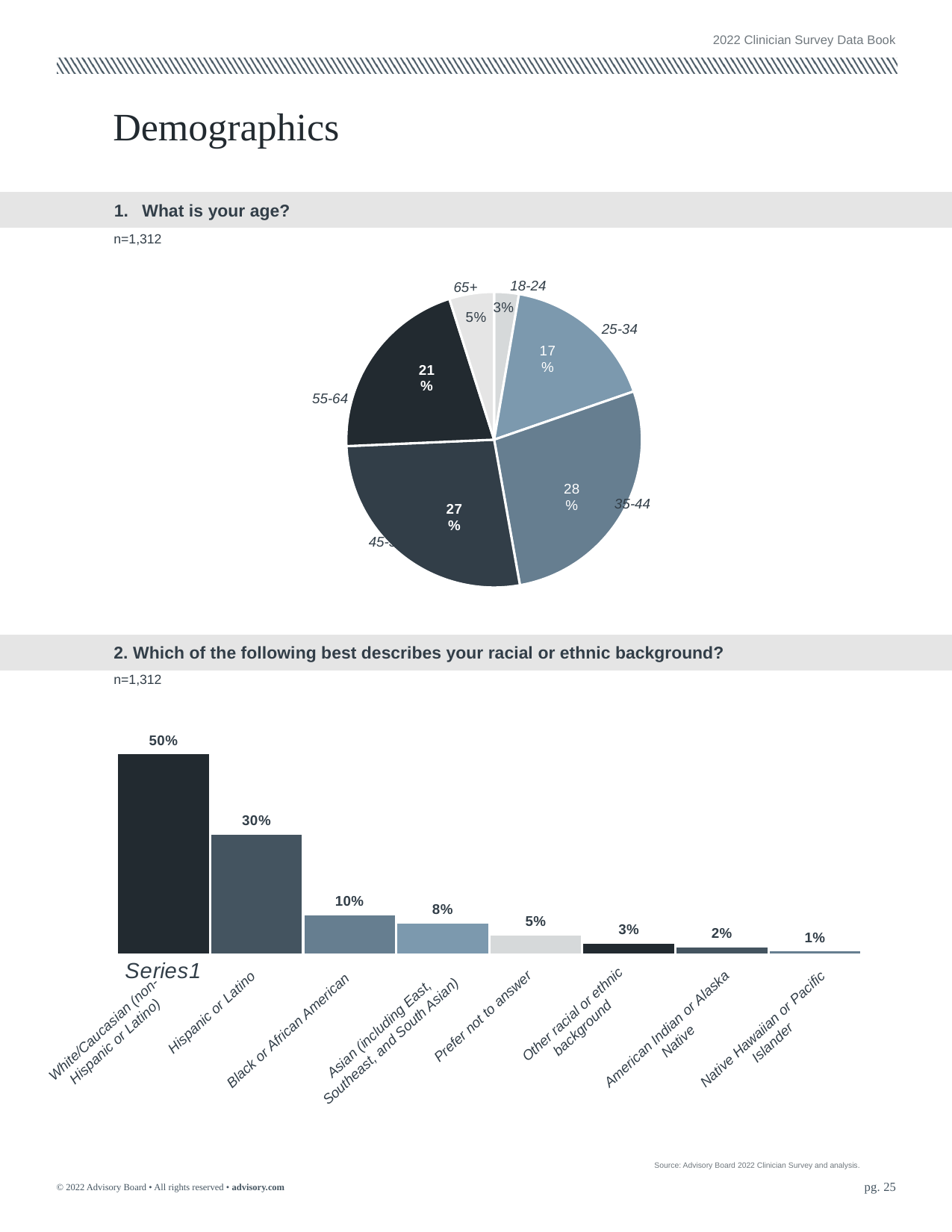
In the 'What is your age?' chart, which age group has the largest share? 35-44 In the racial or ethnic background chart, what percentage of respondents chose 'Prefer not to answer'? 5% In the racial or ethnic background chart, how many categories are shown? 8 In the 'What is your age?' chart, what percentage of respondents are aged 65+? 5% In the 'What is your age?' chart, what percentage of respondents are aged 25-34? 17% In the 'What is your age?' chart, which age group has the smallest share? 18-24 In the racial or ethnic background chart, what percentage of respondents are Hispanic or Latino? 30% In the racial or ethnic background chart, which category has the highest value? White/Caucasian (non-Hispanic or Latino) In the 'What is your age?' chart, what is the difference between the 55-64 share and the 25-34 share? 4% In the racial or ethnic background chart, what is the difference between Black or African American and Asian (including East, Southeast, and South Asian)? 2% In the 'What is your age?' chart, what percentage of respondents are aged 35-44? 28% What kind of chart is used for the 'What is your age?' question? Pie chart